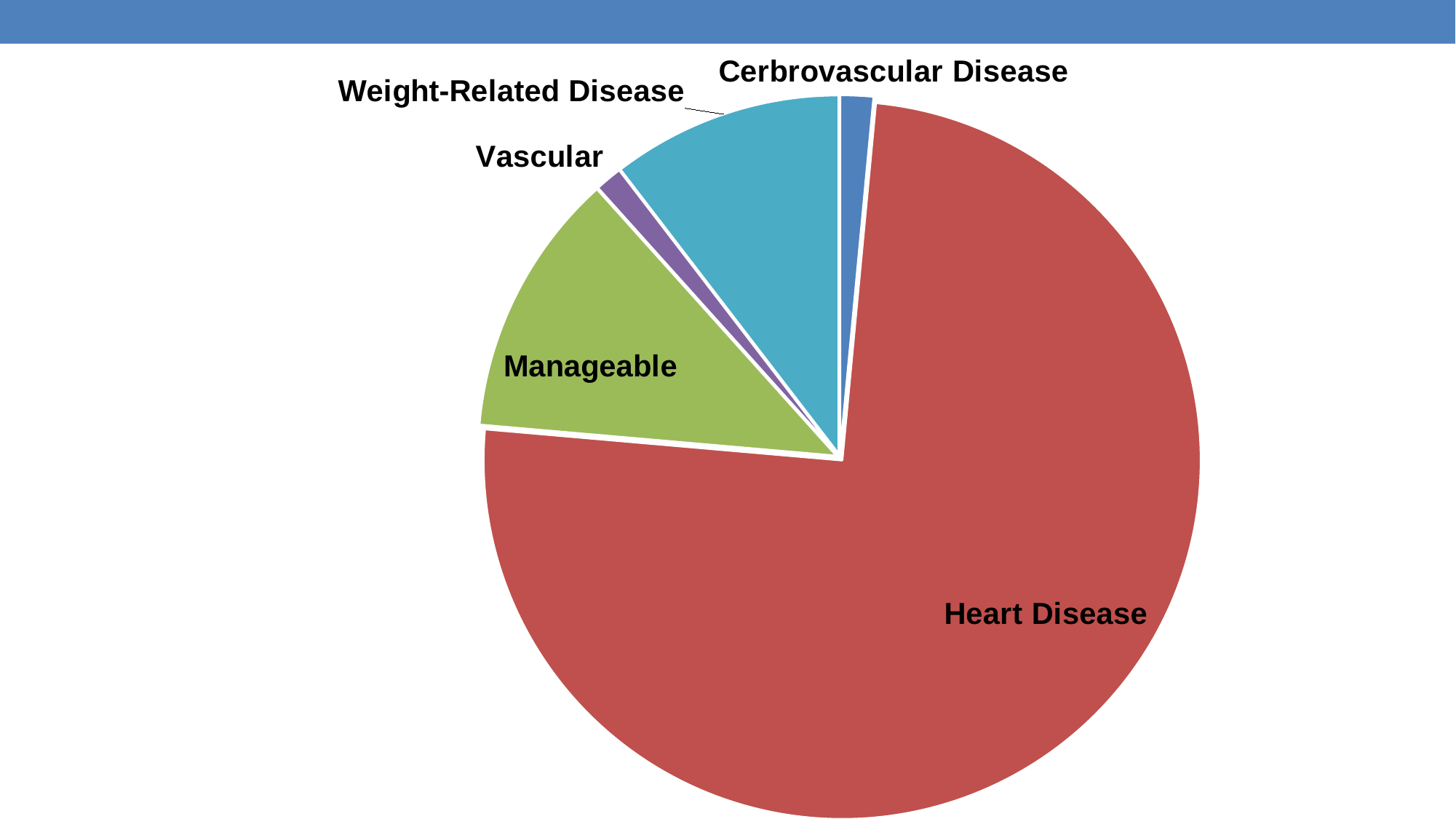
Which category has the largest slice of the pie chart? Heart Disease Which slice is larger, Heart Disease or Cerbrovascular Disease? Heart Disease What kind of chart is shown on the slide? pie chart What colour is the Manageable slice? green How many slices does the pie chart have? 5 Does the Heart Disease slice take up more or less than half of the pie? more What colour is the Heart Disease slice? red Which slice is larger, Heart Disease or Manageable? Heart Disease Which slice is larger, Manageable or Weight-Related Disease? Manageable